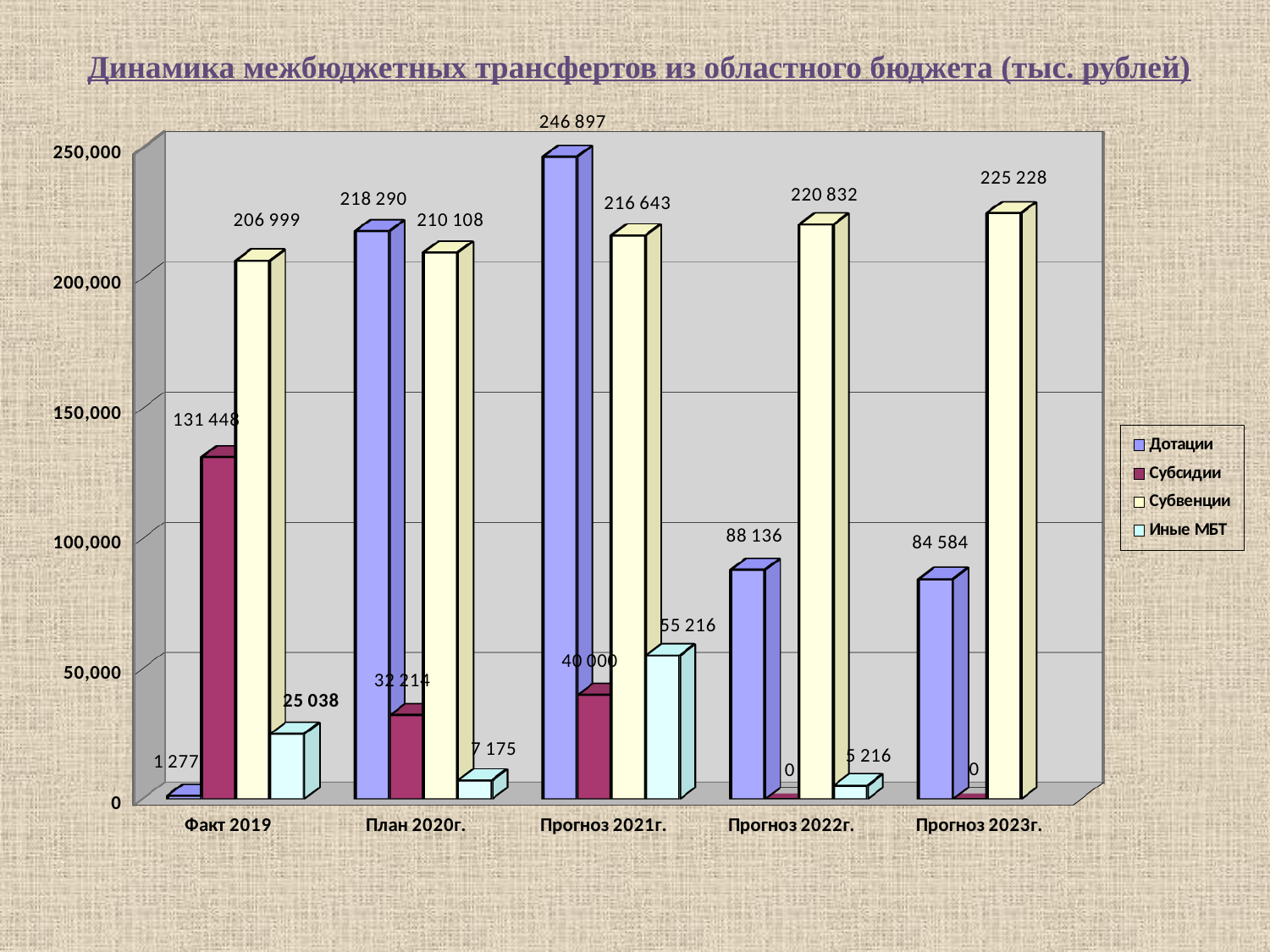
What is the value of Иные МБТ for План 2020г.? 7 175 How many categories are shown on the x axis? 5 What is the value of Субвенции for Прогноз 2023г.? 225 228 In which category is the Дотации value lowest? Факт 2019 What kind of chart is shown on the slide? Bar chart In which category is the Дотации value highest? Прогноз 2021г. What is the difference between the Субвенции values for Прогноз 2022г. and План 2020г.? 10 724 Which series is shown in yellow in the legend? Субвенции What is the value of Субсидии for Факт 2019? 131 448 Which is larger for План 2020г.: Дотации or Субвенции? Дотации What is the value of Дотации for Прогноз 2021г.? 246 897 How many series does the legend list? 4